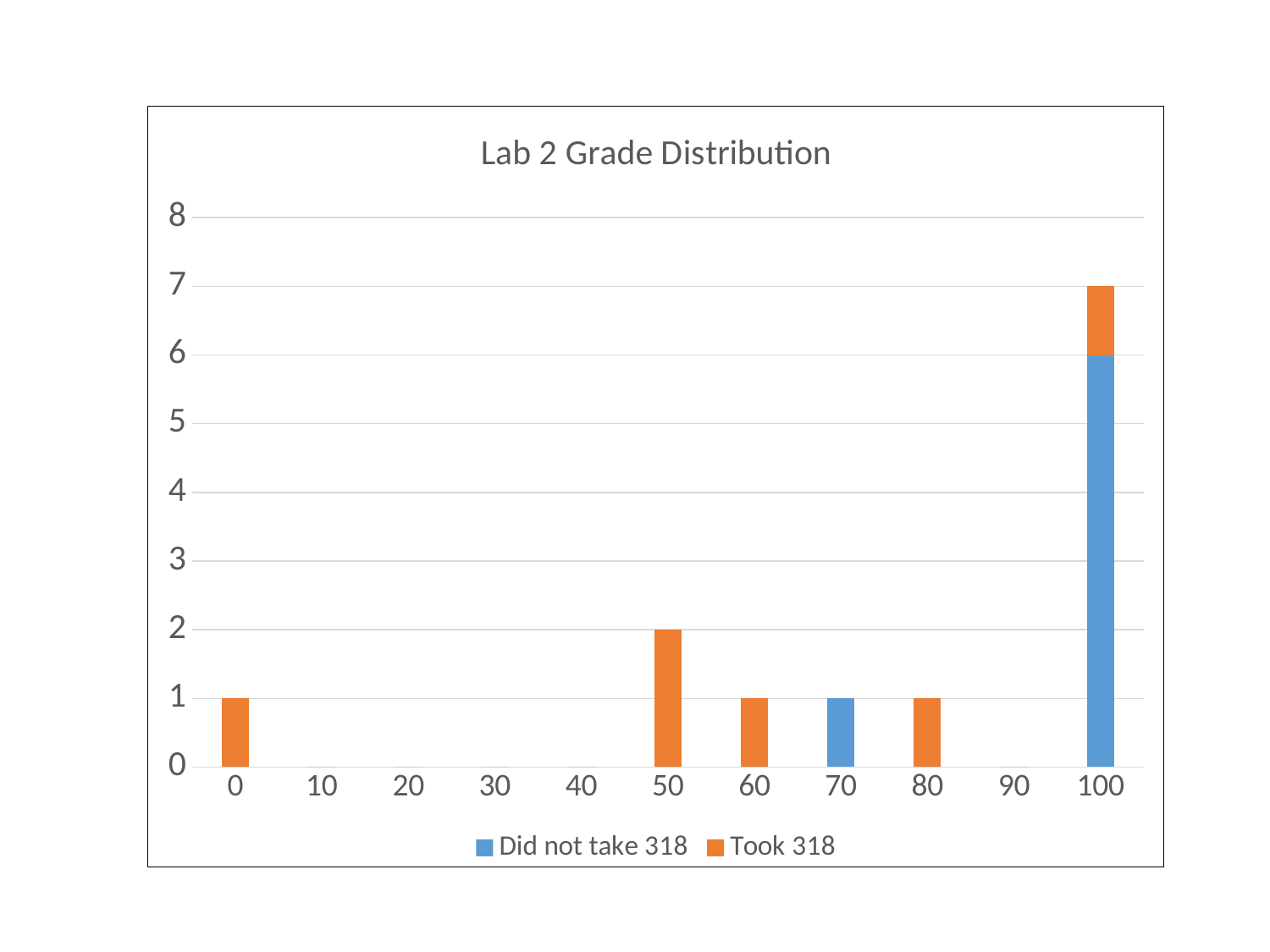
What is the title of the chart? Lab 2 Grade Distribution What is the total height of the stacked bar for grade 100? 7 What is the value for 'Did not take 318' at grade 100? 6 How many series does the legend list? 2 Which colour represents the 'Took 318' series? Orange What is the difference between the 'Did not take 318' value and the 'Took 318' value at grade 100? 5 How many categories are shown on the x axis? 11 Which grade category has the tallest bar? 100 What is the value for 'Did not take 318' at grade 70? 1 Which is larger: the 'Took 318' value at grade 50 or the 'Took 318' value at grade 60? Grade 50 What kind of chart is shown on the slide? Stacked bar chart What is the value for 'Took 318' at grade 50? 2